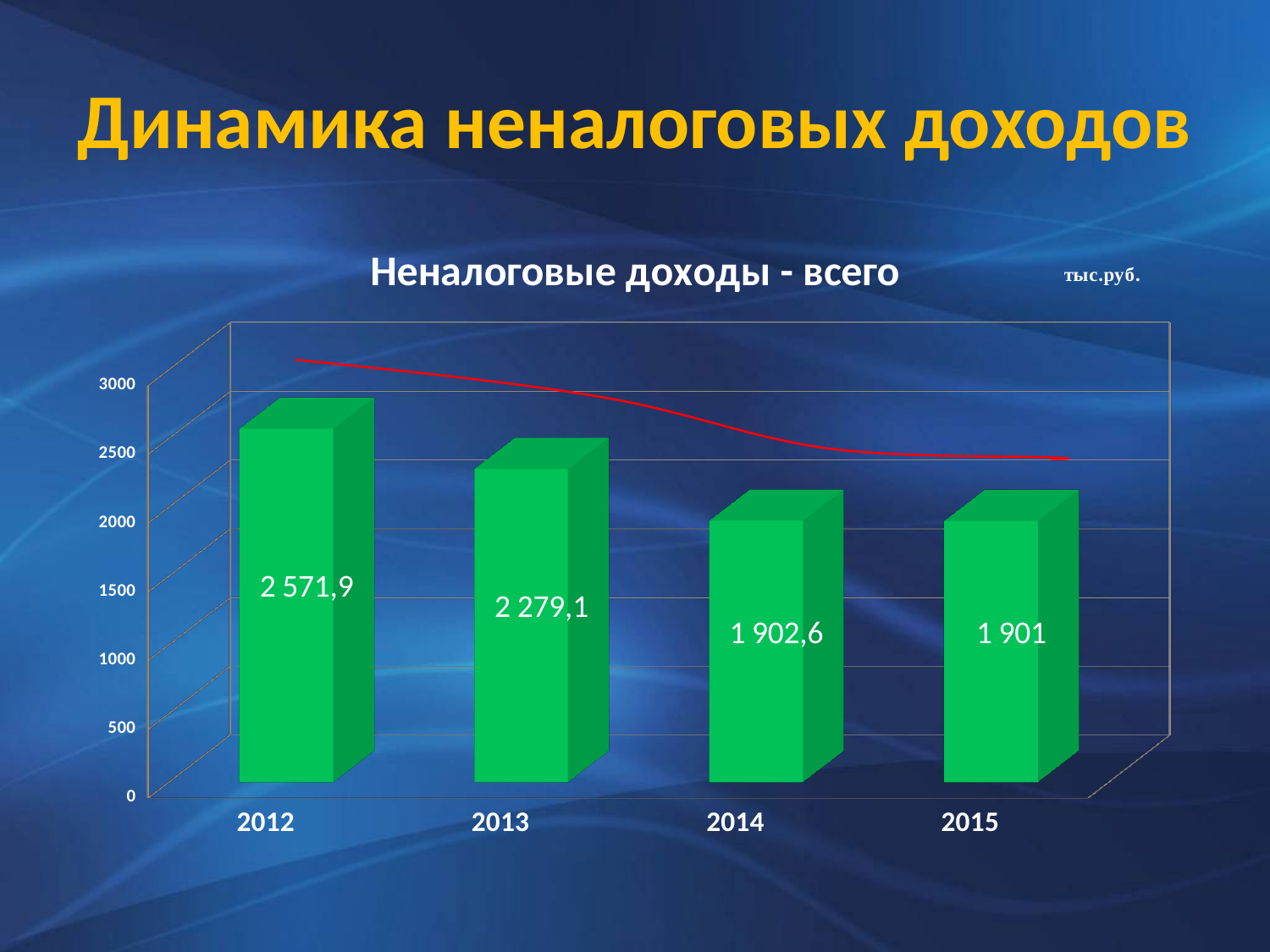
How many years are shown on the x axis? 4 Is the value for 2014 greater or less than 2000? less What is the difference between the values for 2013 and 2014? 376,5 Which year has the lowest value? 2015 What is the value for 2012? 2 571,9 Do the values rise or fall from 2012 to 2015? fall What is the difference between the values for 2012 and 2013? 292,8 Which year has the highest value? 2012 Which is larger, the value for 2012 or the value for 2013? 2012 What is the value for 2014? 1 902,6 What is the value for 2015? 1 901 What kind of chart is shown on the slide? bar chart